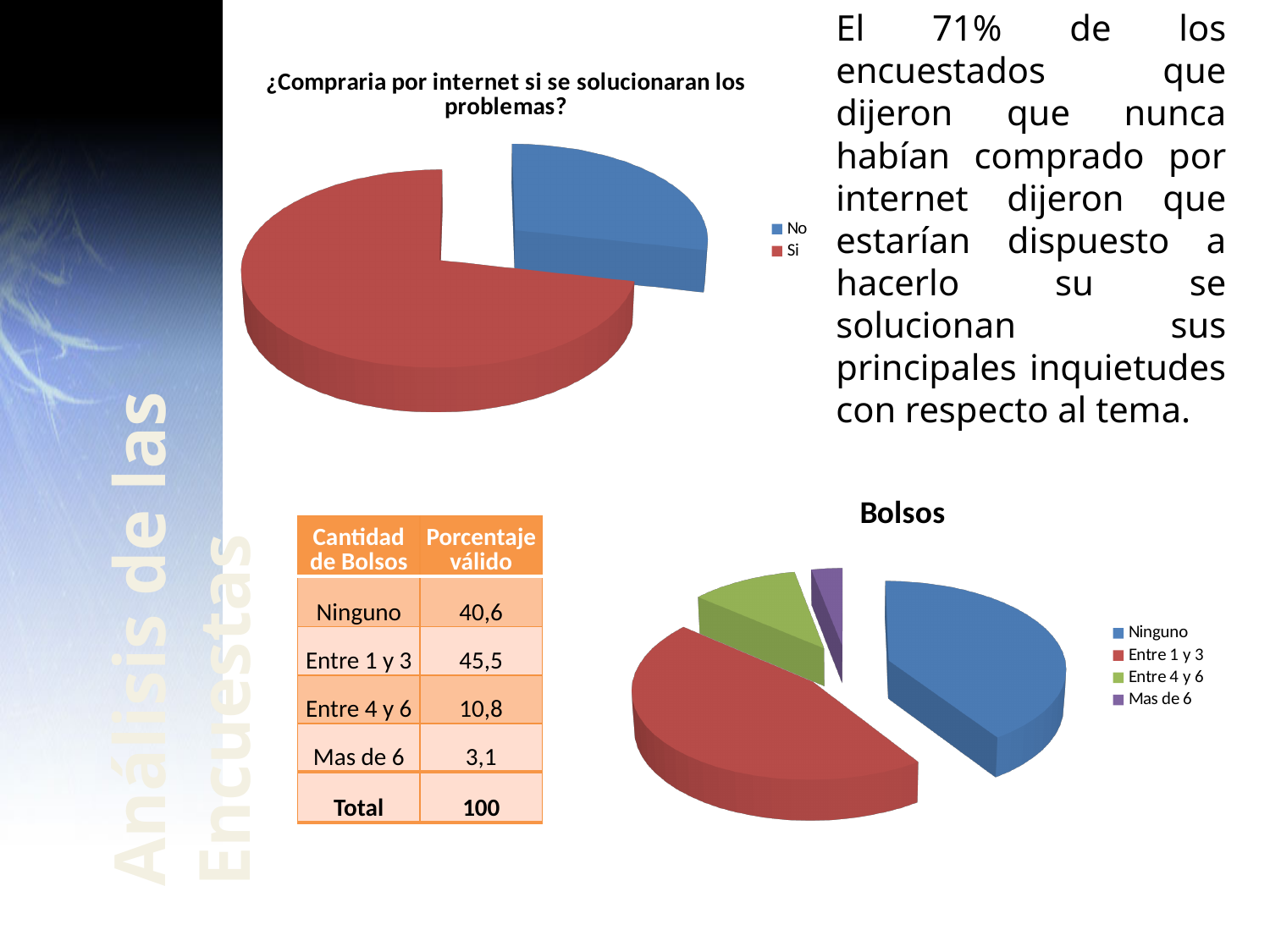
In the chart titled "¿Compraria por internet si se solucionaran los problemas?", which slice is larger, No or Si? Si According to the table next to the chart titled "Bolsos", what is the percentage for Mas de 6? 3,1 What kind of chart is the chart titled "¿Compraria por internet si se solucionaran los problemas?"? pie chart In the chart titled "¿Compraria por internet si se solucionaran los problemas?", what colour is the Si slice? red How many entries does the legend of the chart titled "¿Compraria por internet si se solucionaran los problemas?" list? 2 In the chart titled "Bolsos", what colour is the Entre 4 y 6 slice? green What kind of chart is the chart titled "Bolsos"? pie chart According to the table next to the chart titled "Bolsos", what is the percentage for Entre 1 y 3? 45,5 In the chart titled "Bolsos", which category has the largest slice? Entre 1 y 3 In the chart titled "Bolsos", which category has the smallest slice? Mas de 6 How many categories does the chart titled "Bolsos" show? 4 In the chart titled "Bolsos", which slice is larger, Ninguno or Entre 4 y 6? Ninguno